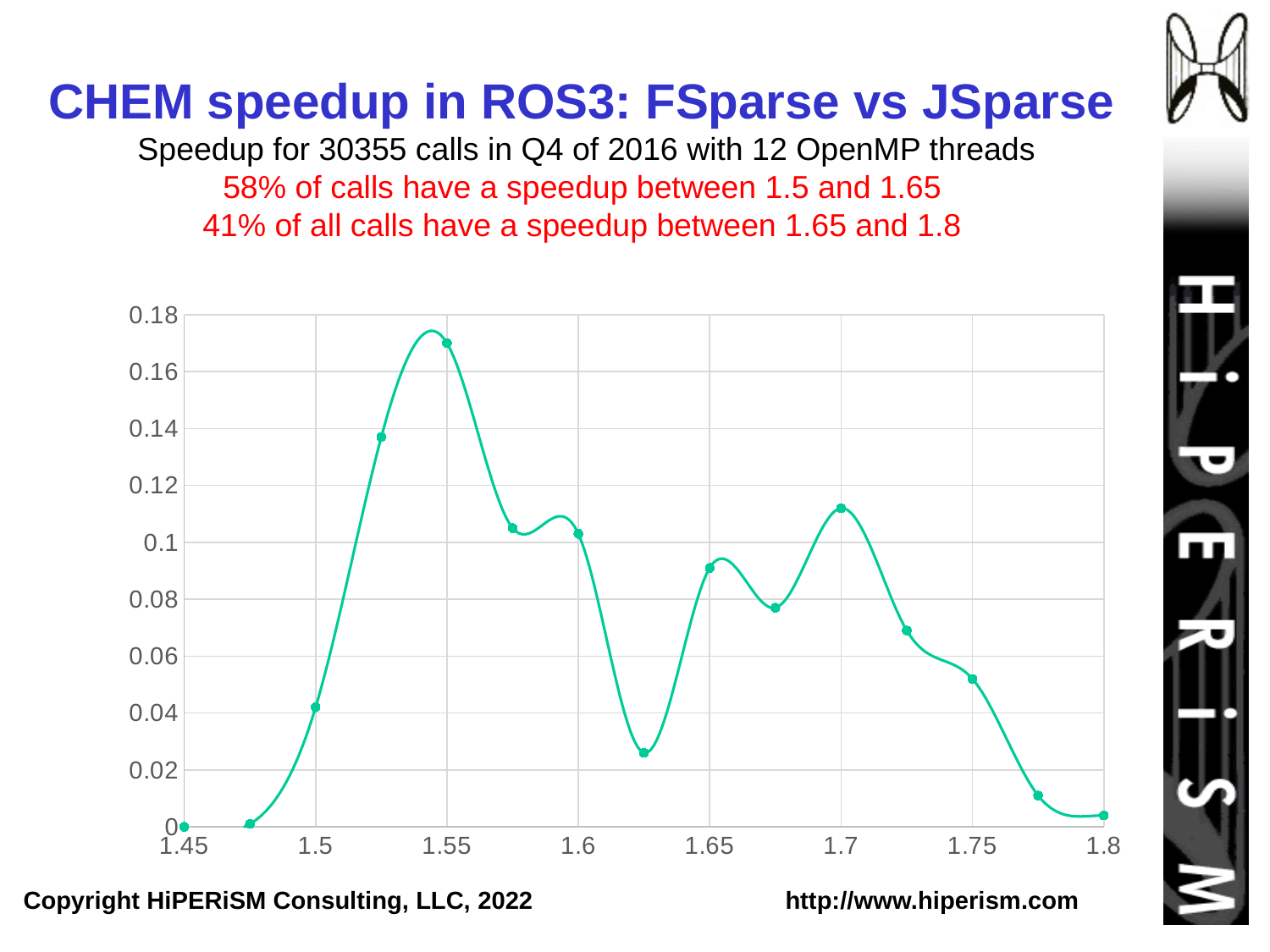
Which has the larger value, x = 1.55 or x = 1.7? 1.55 How many data points are plotted on the line? 15 At which x-axis value does the line reach its highest point? 1.55 Is the value at x = 1.55 greater or less than 0.16? greater What is the title of the slide's chart? CHEM speedup in ROS3: FSparse vs JSparse Is the value at x = 1.7 greater or less than 0.1? greater What kind of chart is shown on the slide? line chart Is the value at x = 1.5 greater or less than 0.06? less What is the plotted value at x = 1.45? 0 Do the values rise or fall along the x axis from 1.7 to 1.8? fall Which has the larger value, x = 1.65 or x = 1.675? 1.65